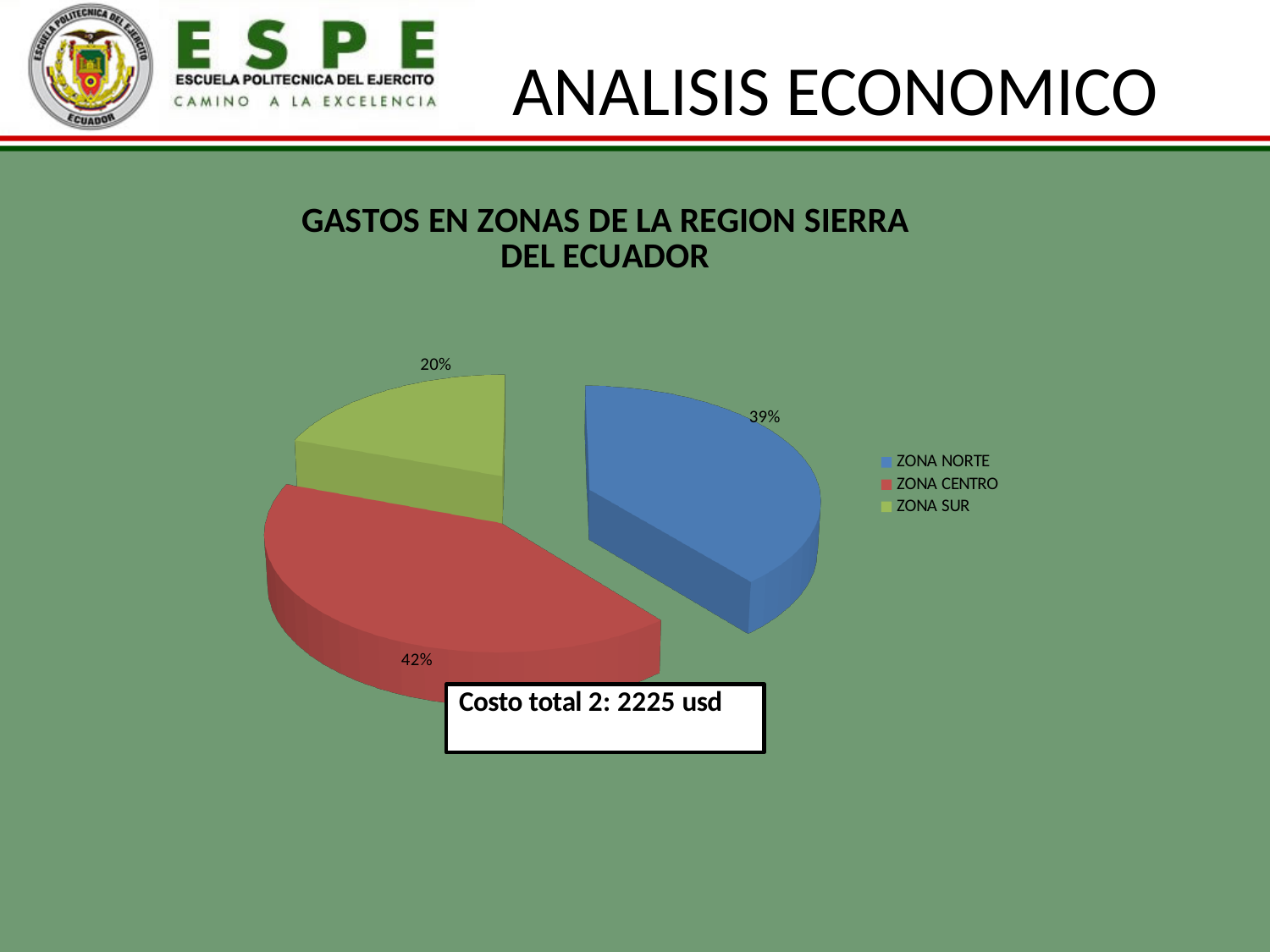
What share of the pie does ZONA CENTRO represent? 42% Which colour represents ZONA CENTRO in the pie chart? Red How many slices does the pie chart have? 3 What share of the pie does ZONA NORTE represent? 39% What is the title of the chart? GASTOS EN ZONAS DE LA REGION SIERRA DEL ECUADOR What is the difference in percentage points between ZONA CENTRO and ZONA SUR? 22 Which is larger, the share for ZONA NORTE or the share for ZONA SUR? ZONA NORTE Which zone has the largest share of the pie? ZONA CENTRO Which zone has the smallest share of the pie? ZONA SUR What is the difference in percentage points between ZONA NORTE and ZONA SUR? 19 What share of the pie does ZONA SUR represent? 20% What kind of chart is shown on the slide? Pie chart